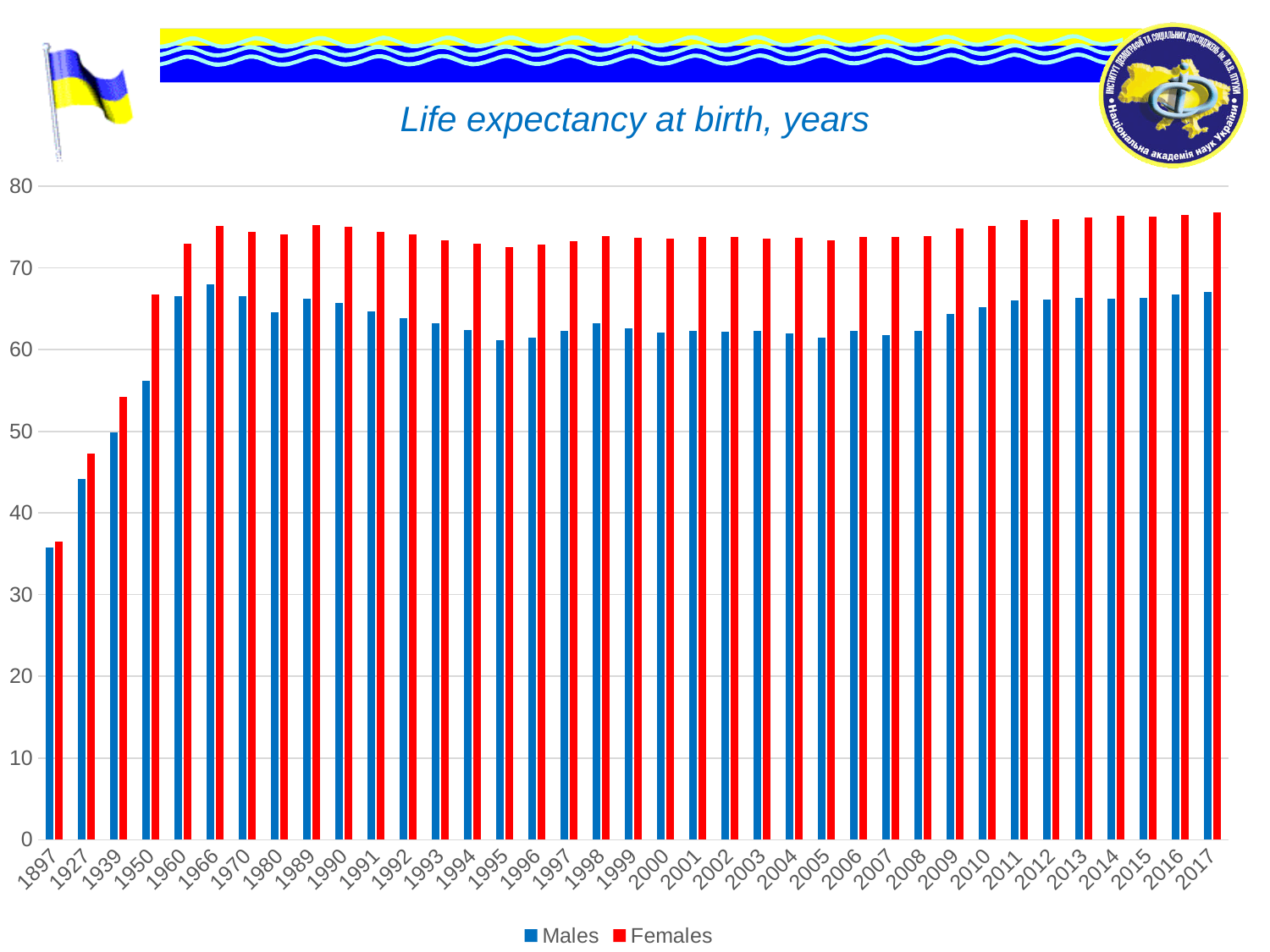
What is the title of the chart? Life expectancy at birth, years Is the value for Males in 1950 greater or less than 60? less What are the two series named in the legend? Males and Females Is the value for Males in 1897 greater or less than 40? less How many series does the legend list? 2 What kind of chart is shown on the slide? bar chart How many years are shown along the x axis? 37 Which year has the lowest value for Females? 1897 In 2017, which is larger, the value for Males or the value for Females? Females Is the value for Females in 1950 greater or less than 60? greater Do the values for Females rise or fall from 1897 to 1960? rise Which year has the lowest value for Males? 1897